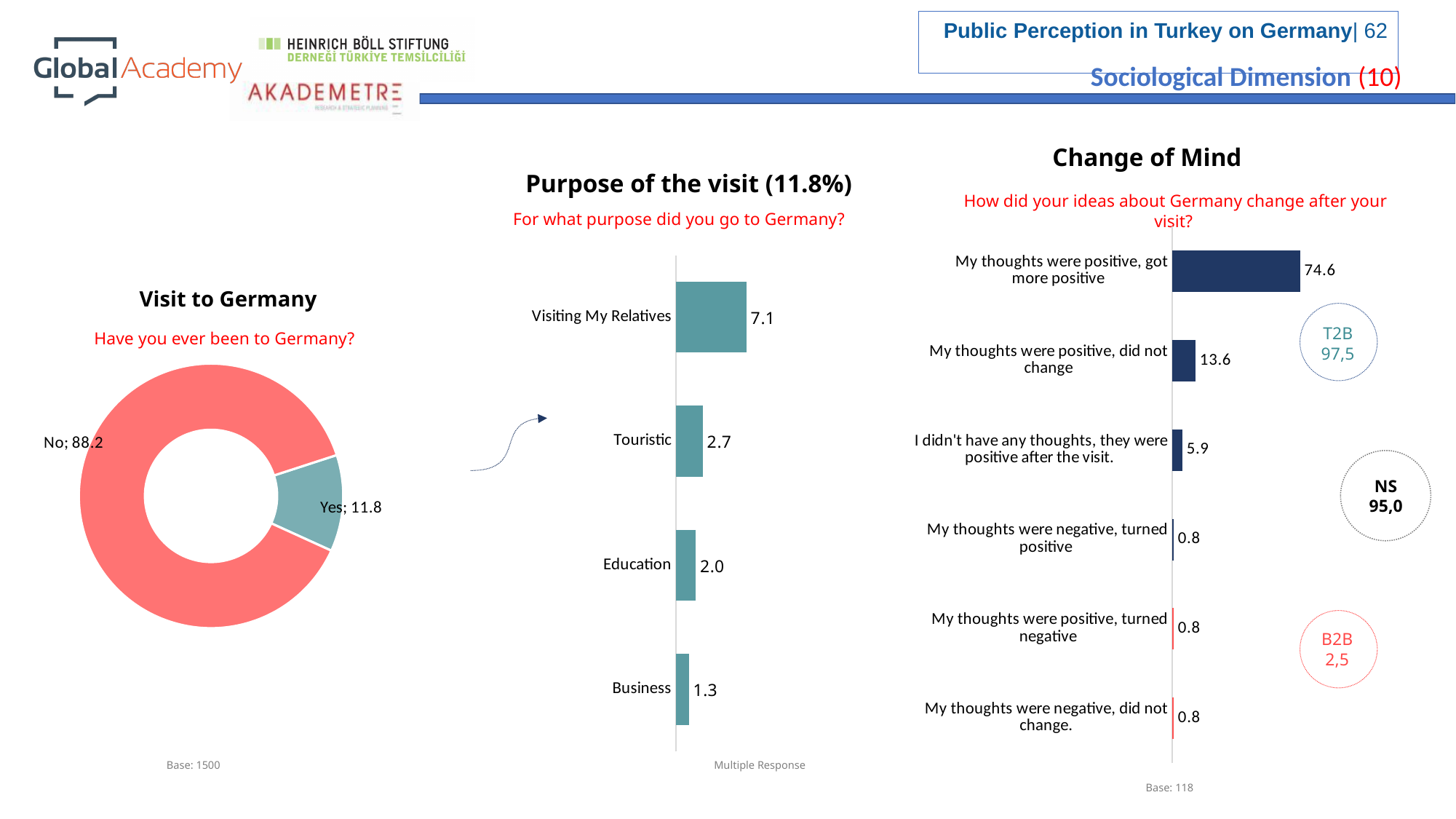
In the 'Visit to Germany' chart, what share of respondents answered Yes? 11.8 In the 'Change of Mind' chart, how many response categories are shown? 6 In the 'Purpose of the visit' chart, how many purposes are listed? 4 What kind of chart is the 'Visit to Germany' chart? Doughnut (pie) chart In the 'Purpose of the visit' chart, which purpose has the lowest value? Business In the 'Change of Mind' chart, what is the value for 'My thoughts were positive, did not change'? 13.6 In the 'Change of Mind' chart, which response has the highest value? My thoughts were positive, got more positive In the 'Change of Mind' chart, what is the difference between 'My thoughts were positive, got more positive' and 'My thoughts were positive, did not change'? 61.0 In the 'Visit to Germany' chart, what share of respondents answered No? 88.2 In the 'Purpose of the visit' chart, what is the difference between Touristic and Education? 0.7 In the 'Purpose of the visit' chart, what is the value for Visiting My Relatives? 7.1 In the 'Change of Mind' chart, what is the value for 'My thoughts were positive, got more positive'? 74.6